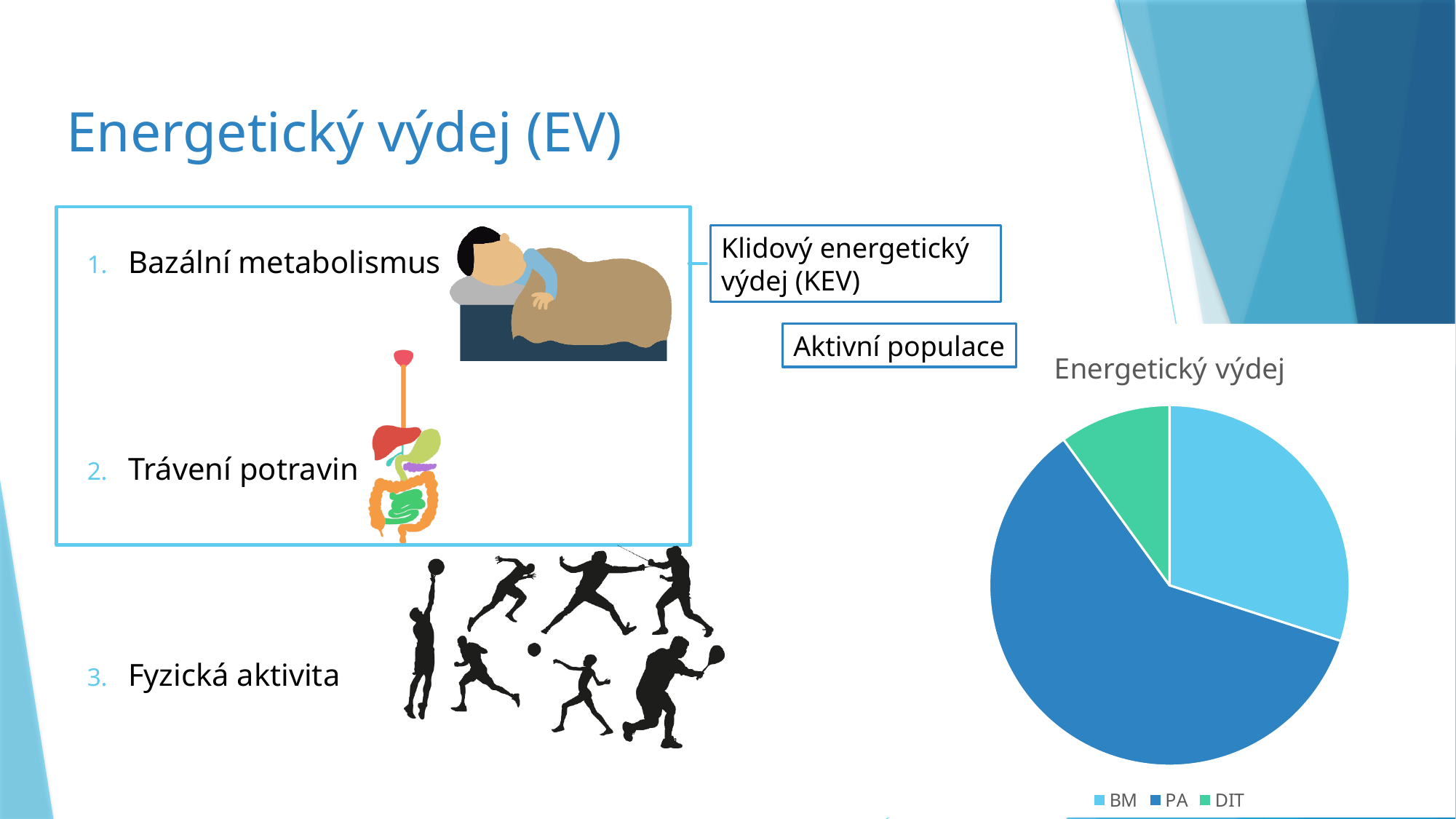
What is the title of the pie chart? Energetický výdej What are the legend entries of the pie chart, in order? BM, PA, DIT Which slice is larger in the pie chart, PA or DIT? PA Which slice is larger in the pie chart, BM or DIT? BM Which category has the smallest slice in the pie chart? DIT How many entries does the legend of the pie chart list? 3 Which category has the largest slice in the pie chart? PA Which slice is larger in the pie chart, PA or BM? PA What kind of chart is shown on the slide? pie chart How many slices does the pie chart have? 3